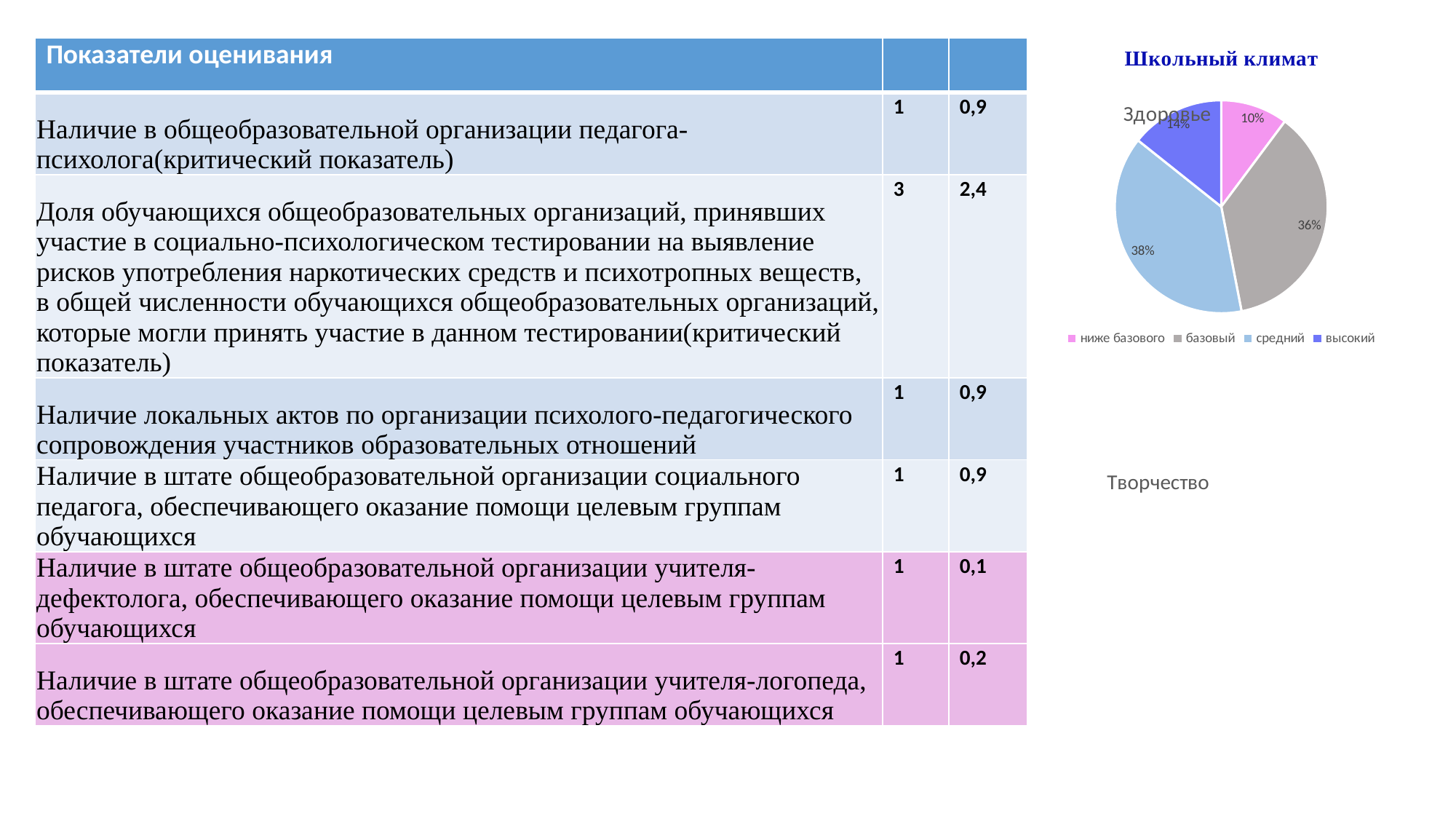
In the "Школьный климат" pie chart, what share does the "средний" slice have? 38% In the "Школьный климат" pie chart, what colour is the "ниже базового" slice? pink In the "Школьный климат" pie chart, what share does the "ниже базового" slice have? 10% In the "Школьный климат" pie chart, what share does the "высокий" slice have? 14% How many entries does the legend of the "Школьный климат" pie chart list? 4 In the "Школьный климат" pie chart, what share does the "базовый" slice have? 36% Which slice of the "Школьный климат" pie chart is the largest? средний What kind of chart is shown under the title "Школьный климат"? pie chart In the "Школьный климат" pie chart, what is the difference in percentage points between the "средний" and "ниже базового" slices? 28 Which slice of the "Школьный климат" pie chart is the smallest? ниже базового In the "Школьный климат" pie chart, which slice is larger: "высокий" or "базовый"? базовый How many slices does the "Школьный климат" pie chart have? 4